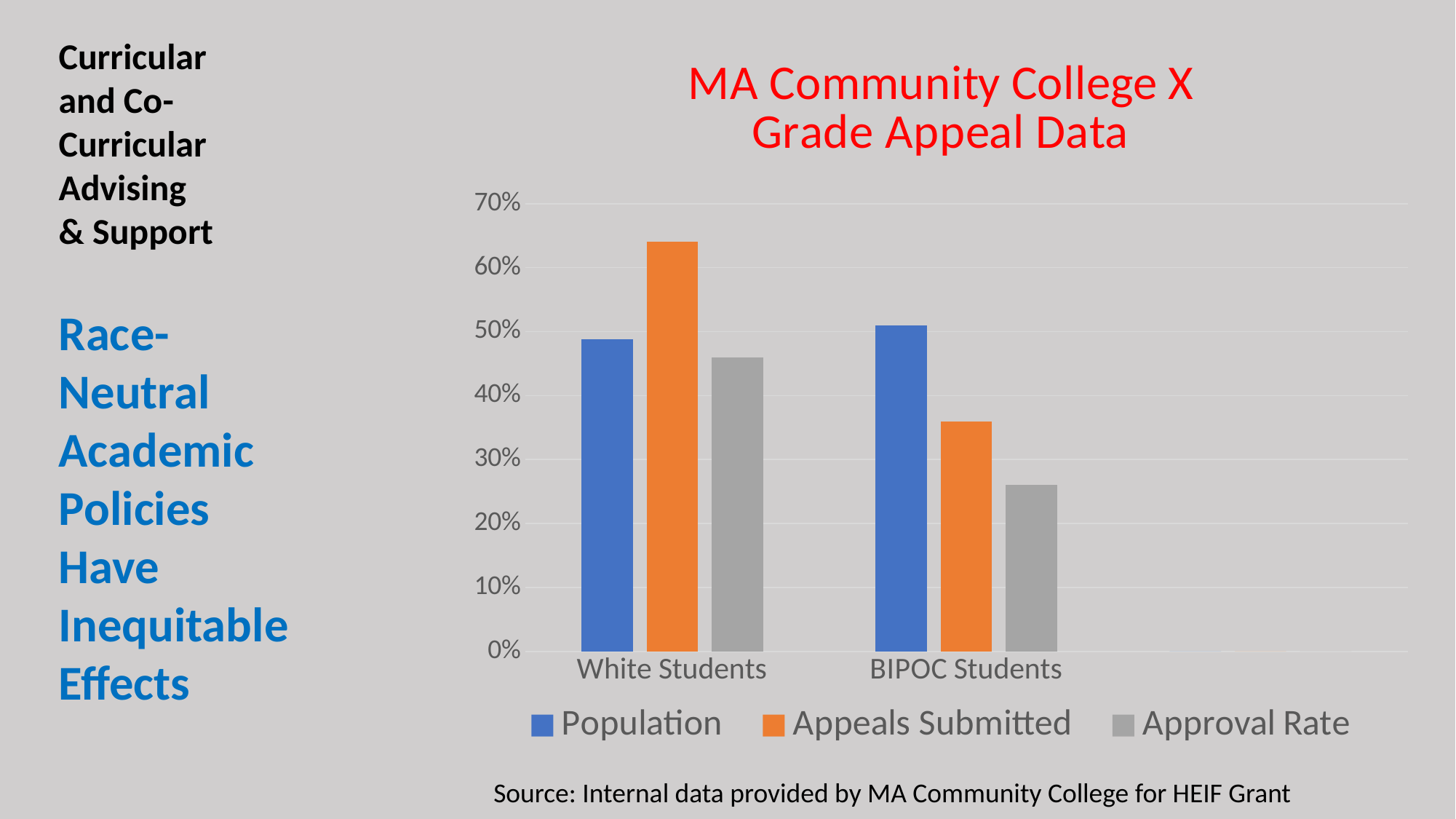
For BIPOC Students, which series has the lowest value? Approval Rate What kind of chart is shown on the slide? Bar chart Is the Appeals Submitted value for White Students greater or less than 60%? greater Which series is shown in orange in the legend? Appeals Submitted Is the Approval Rate for White Students greater or less than 40%? greater How many student categories are shown on the x axis? 2 Which group has the lower Approval Rate, White Students or BIPOC Students? BIPOC Students What is the title of the chart? MA Community College X Grade Appeal Data Is the Approval Rate for BIPOC Students greater or less than 30%? less How many series does the chart's legend list? 3 Which group has the higher Appeals Submitted value, White Students or BIPOC Students? White Students